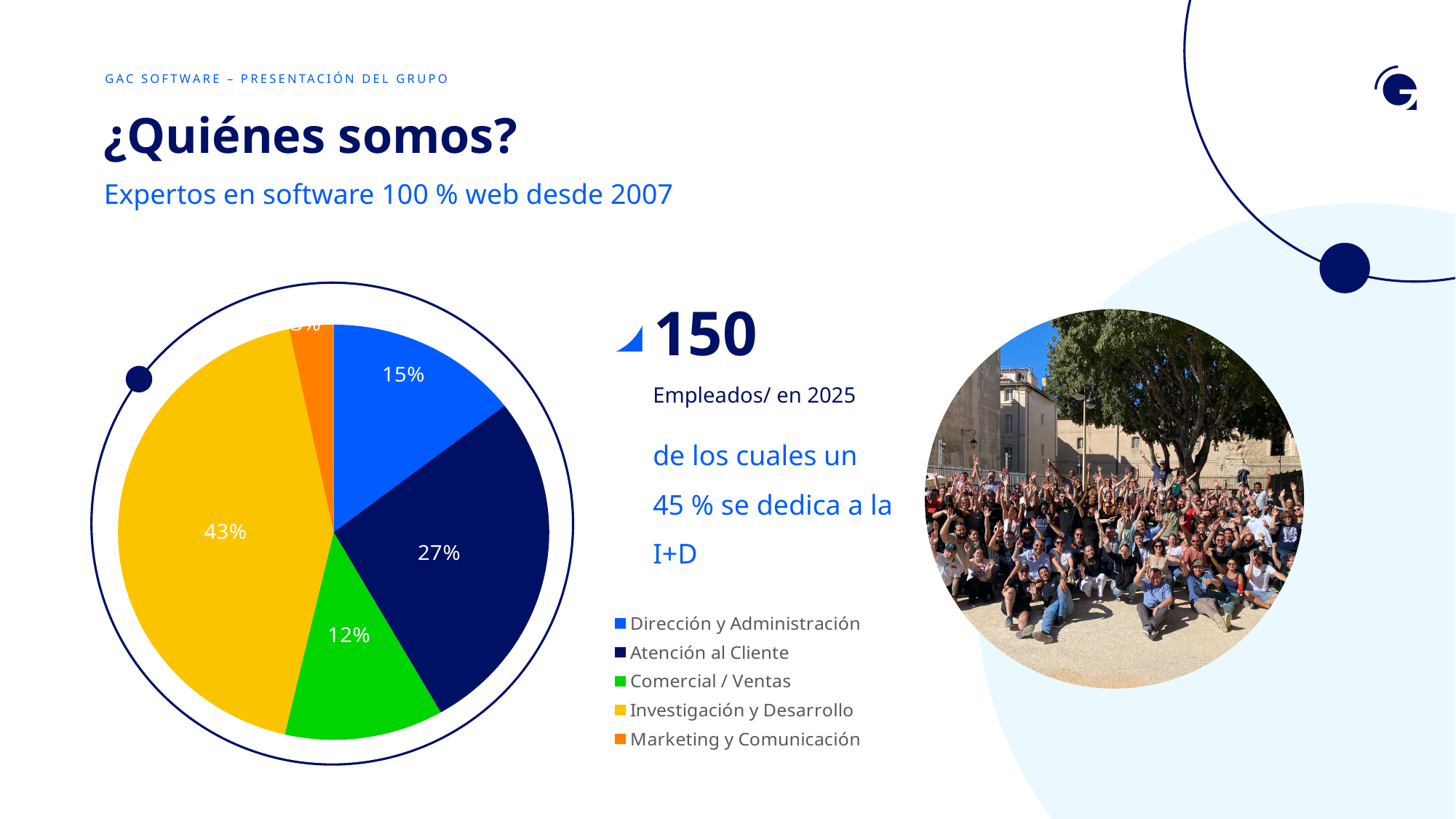
Which is larger: the slice for Dirección y Administración or the slice for Comercial / Ventas? Dirección y Administración What share of the pie chart is Dirección y Administración? 15% Which category has the smallest slice of the pie chart? Marketing y Comunicación What kind of chart is shown on the slide? Pie chart What colour is the Comercial / Ventas slice in the pie chart? Green What share of the pie chart is Investigación y Desarrollo? 43% What is the difference in percentage points between Investigación y Desarrollo and Atención al Cliente? 16 What share of the pie chart is Atención al Cliente? 27% Which category has the largest slice of the pie chart? Investigación y Desarrollo What share of the pie chart is Comercial / Ventas? 12% How many entries does the legend list? 5 How many categories does the pie chart show? 5